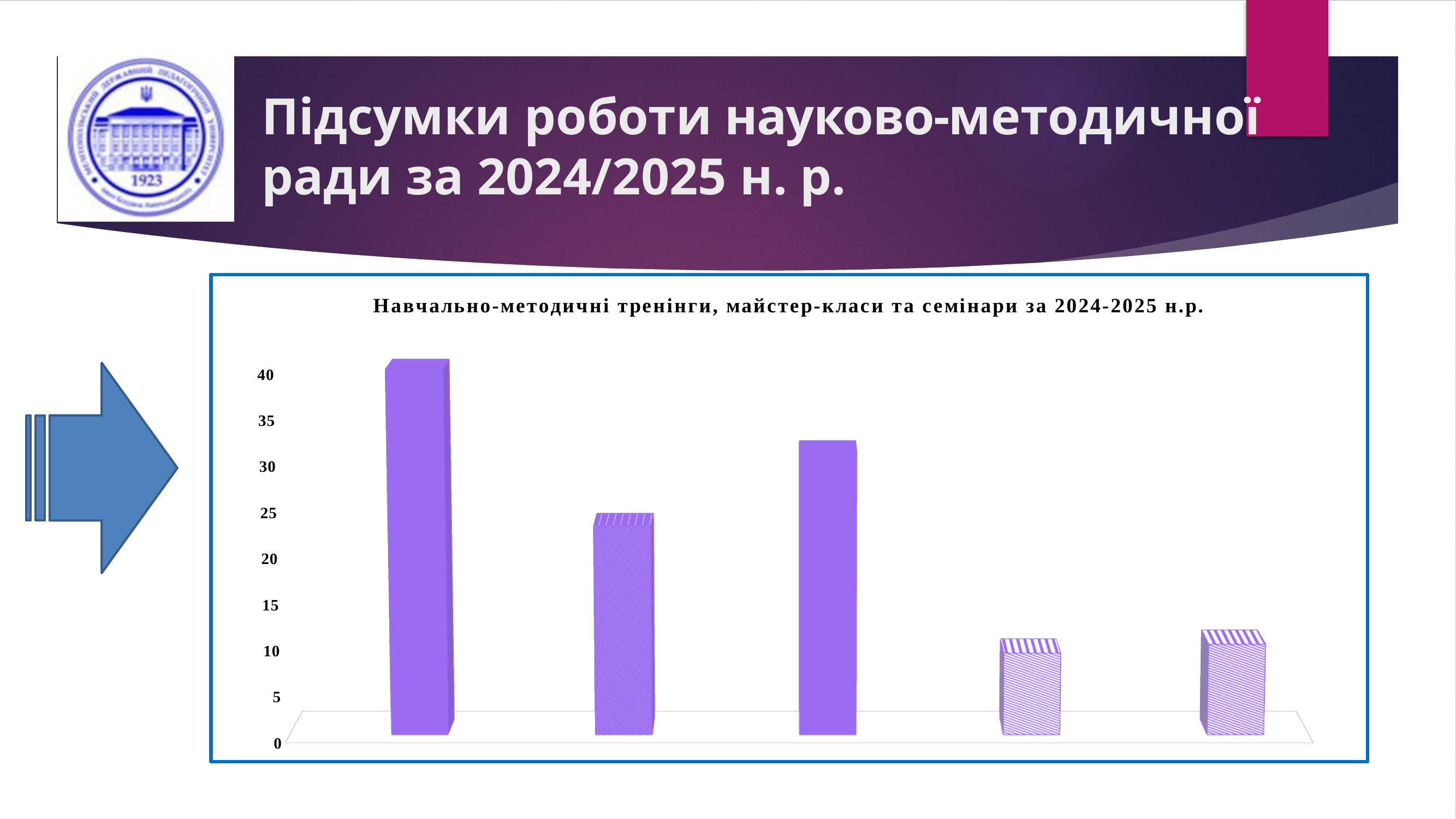
Is the value of the third bar from the left greater or less than 30? greater How many bars does the chart show? 5 What is the title of the chart? Навчально-методичні тренінги, майстер-класи та семінари за 2024-2025 н.р. Is the value of the fourth bar from the left greater or less than 15? less What is the highest value labelled on the vertical axis? 40 Which is larger: the leftmost bar or the third bar from the left? the leftmost bar Which bar is the tallest in the chart? the leftmost (first) bar Which is larger: the second bar from the left or the third bar from the left? the third bar from the left Is the value of the second bar from the left greater or less than 20? greater What kind of chart is shown on the slide? bar chart